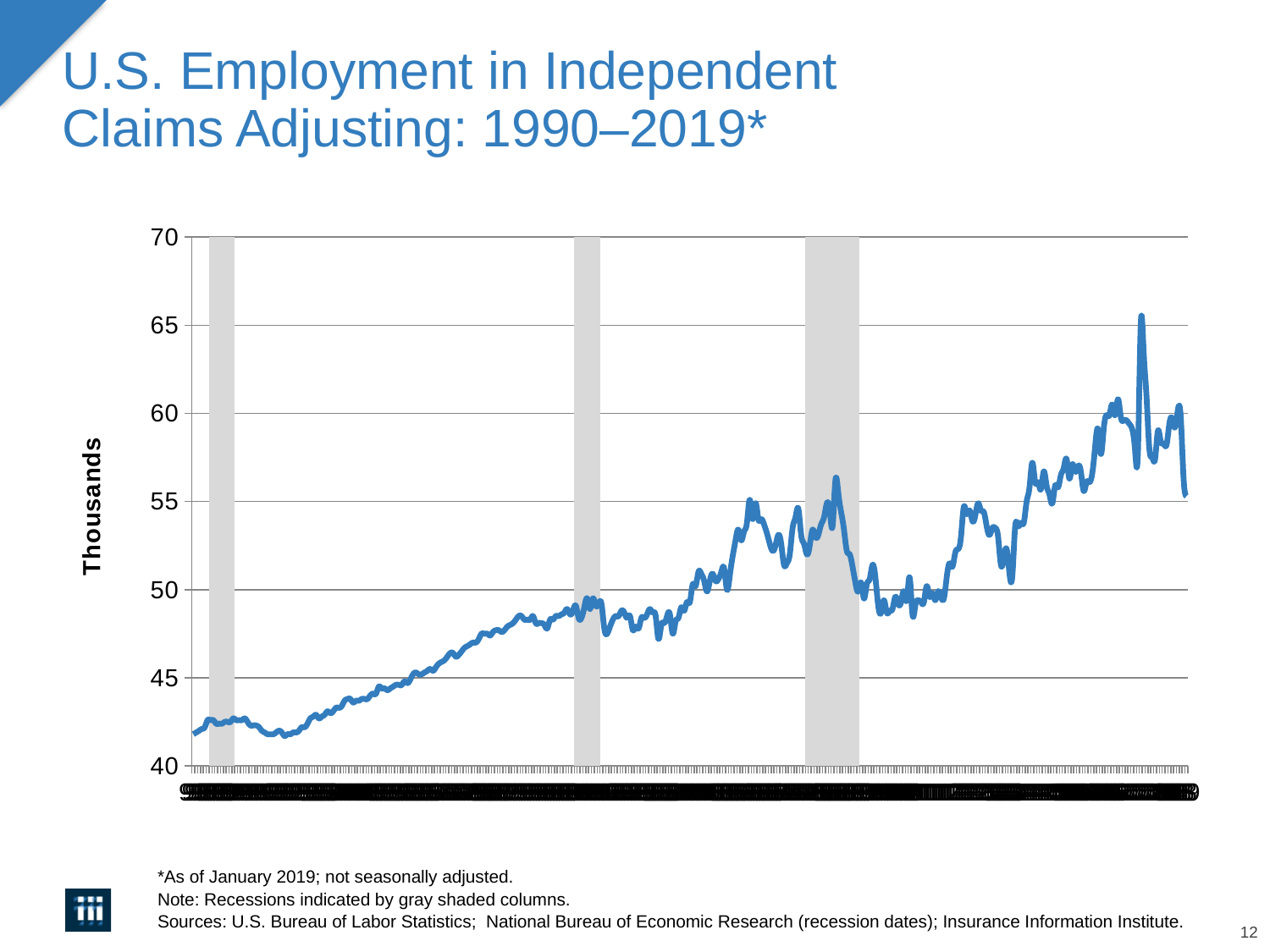
What kind of chart is shown on the slide? line chart Overall, do the values rise or fall from the left of the x axis to the right? rise How many gray shaded recession columns are shown on the chart? 3 Is the value at the end of the series (right end) greater or less than 60? less Is the value at the start of the series greater or less than 40? greater Is the value at the start of the series (left end) greater or less than 45? less What is the label on the vertical axis? Thousands Which is larger, the value at the start of the series or the value at the end of the series? the value at the end